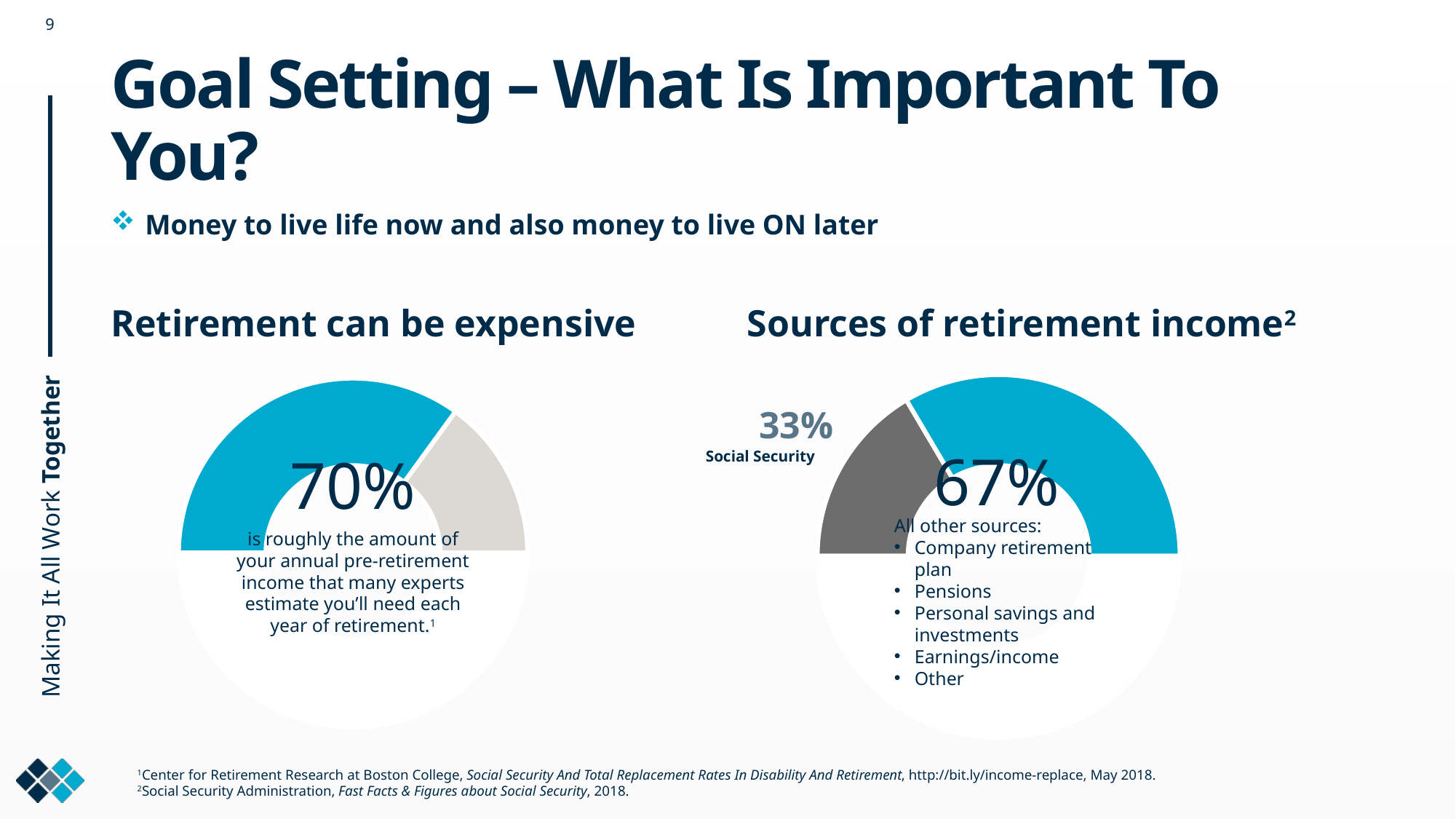
What type of chart is used for 'Sources of retirement income'? Pie (donut) chart How many charts are shown on the slide? 2 In the 'Sources of retirement income' chart, what share of retirement income comes from Social Security? 33% In the 'Sources of retirement income' chart, what colour is the Social Security segment? Grey In the 'Sources of retirement income' chart, what share of retirement income comes from all other sources? 67% What is the title of the chart on the left side of the slide? Retirement can be expensive How many segments does the 'Sources of retirement income' chart have? 2 In the 'Sources of retirement income' chart, which source has the larger share: Social Security or all other sources? All other sources In the 'Retirement can be expensive' chart, what percentage is shown in the highlighted blue segment? 70% In the 'Sources of retirement income' chart, which segment is the smallest? Social Security In the 'Sources of retirement income' chart, by how many percentage points does the share for all other sources exceed the share for Social Security? 34 percentage points